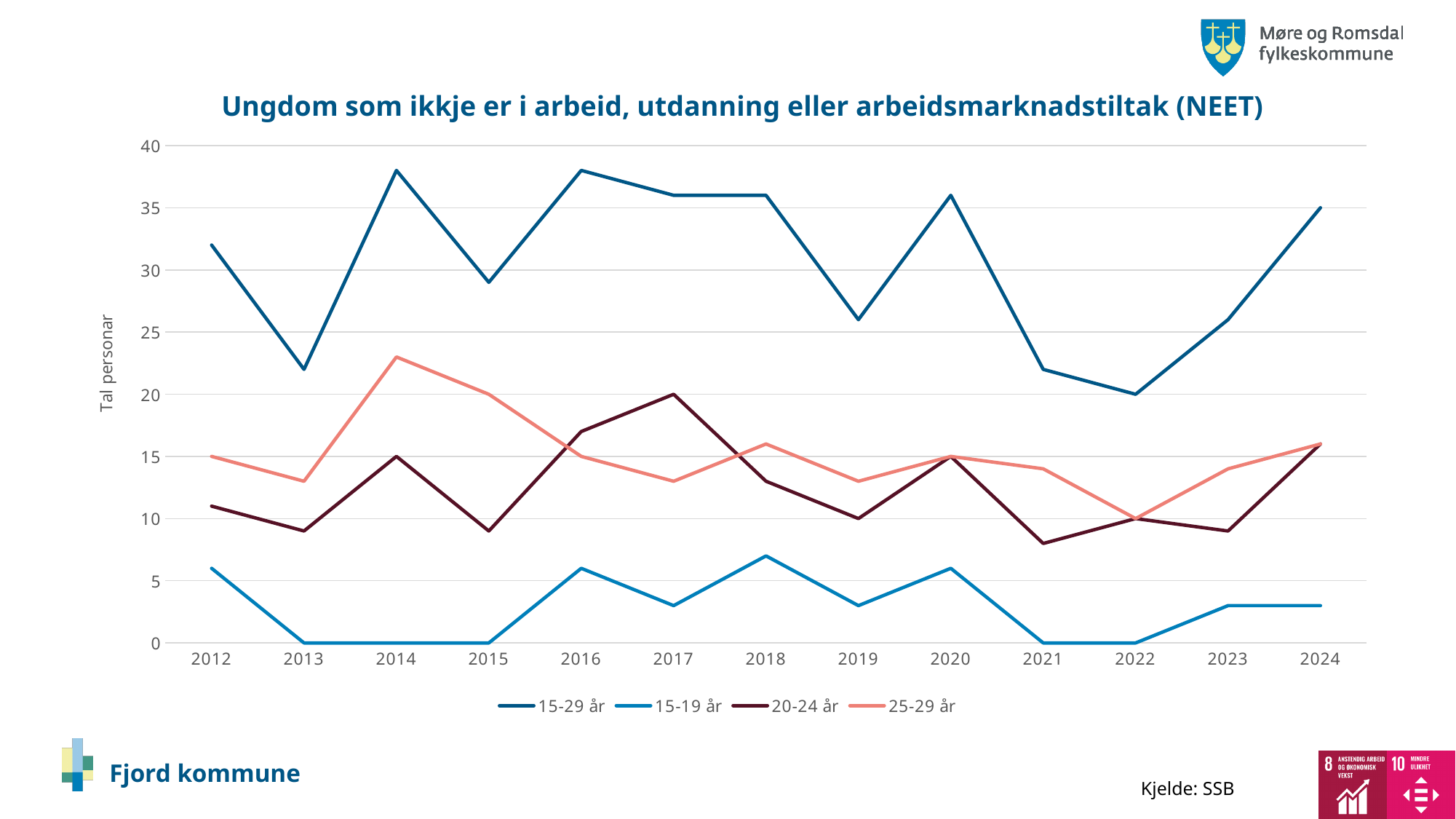
Is the value for 20-24 år in 2021 greater or less than 10? less How many series does the legend list? 4 What is the value for 15-29 år in 2022? 20 What is the value for 15-19 år in 2013? 0 Is the value for 15-29 år in 2014 greater or less than 35? greater Which is larger in 2017, 20-24 år or 25-29 år? 20-24 år What is the value for 20-24 år in 2017? 20 What kind of chart is shown on the slide? line chart What is the value for 25-29 år in 2022? 10 What is the difference between 15-29 år and 25-29 år in 2022? 10 How many years are shown on the x axis? 13 In which year is the 25-29 år series highest? 2014